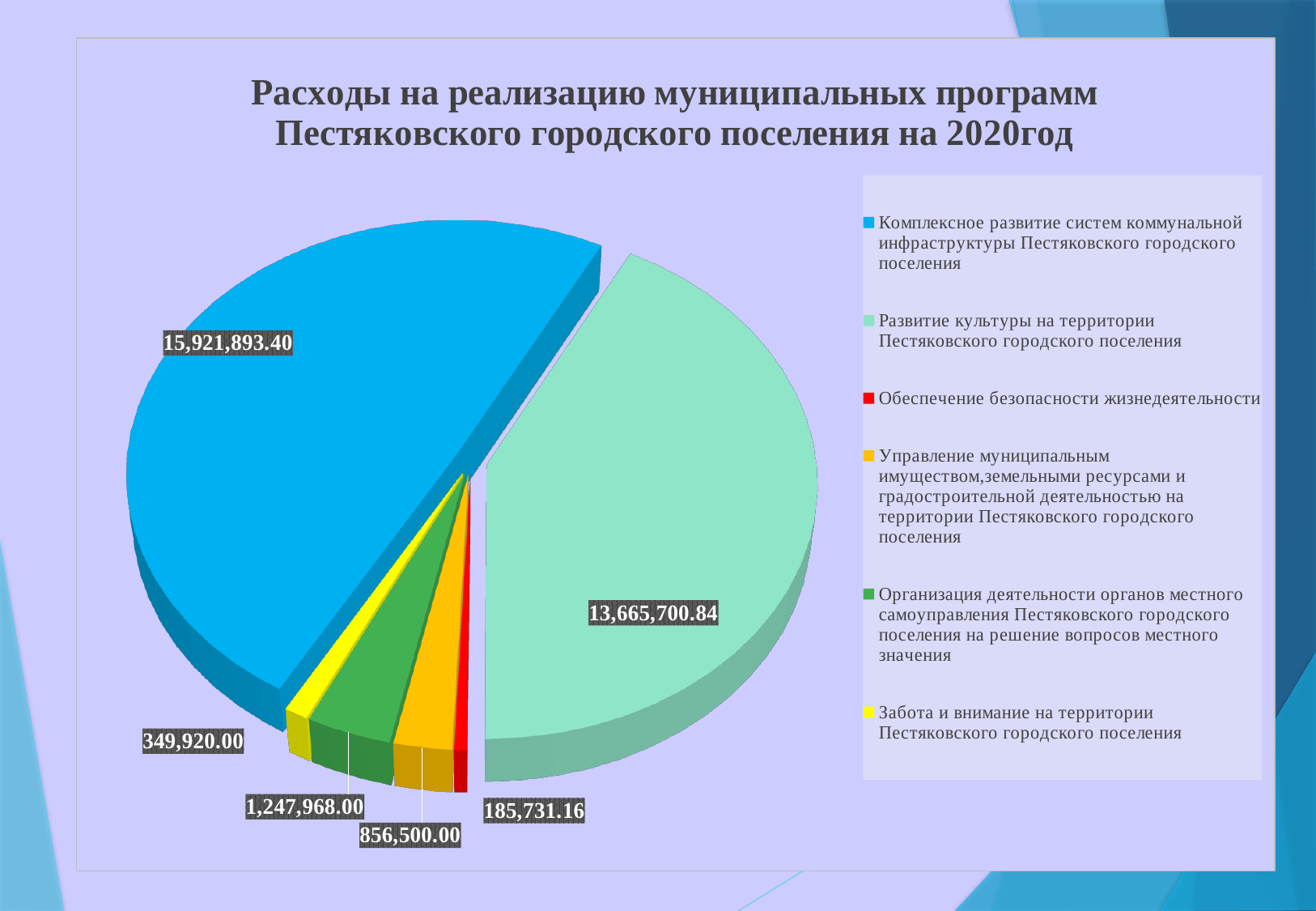
How many categories does the pie chart show? 6 What is the title of the chart? Расходы на реализацию муниципальных программ Пестяковского городского поселения на 2020год What is the difference between the values for «Комплексное развитие систем коммунальной инфраструктуры» and «Развитие культуры»? 2,256,192.56 What is the value for «Забота и внимание на территории Пестяковского городского поселения»? 349,920.00 What is the value for «Развитие культуры на территории Пестяковского городского поселения»? 13,665,700.84 What kind of chart is shown on the slide? Pie chart Which category has the smallest value? Обеспечение безопасности жизнедеятельности What is the value for «Комплексное развитие систем коммунальной инфраструктуры Пестяковского городского поселения»? 15,921,893.40 What is the value for «Организация деятельности органов местного самоуправления Пестяковского городского поселения на решение вопросов местного значения»? 1,247,968.00 What is the value for «Обеспечение безопасности жизнедеятельности»? 185,731.16 Which is larger: the value for «Управление муниципальным имуществом, земельными ресурсами и градостроительной деятельностью» or for «Забота и внимание»? Управление муниципальным имуществом, земельными ресурсами и градостроительной деятельностью Which category has the largest value? Комплексное развитие систем коммунальной инфраструктуры Пестяковского городского поселения